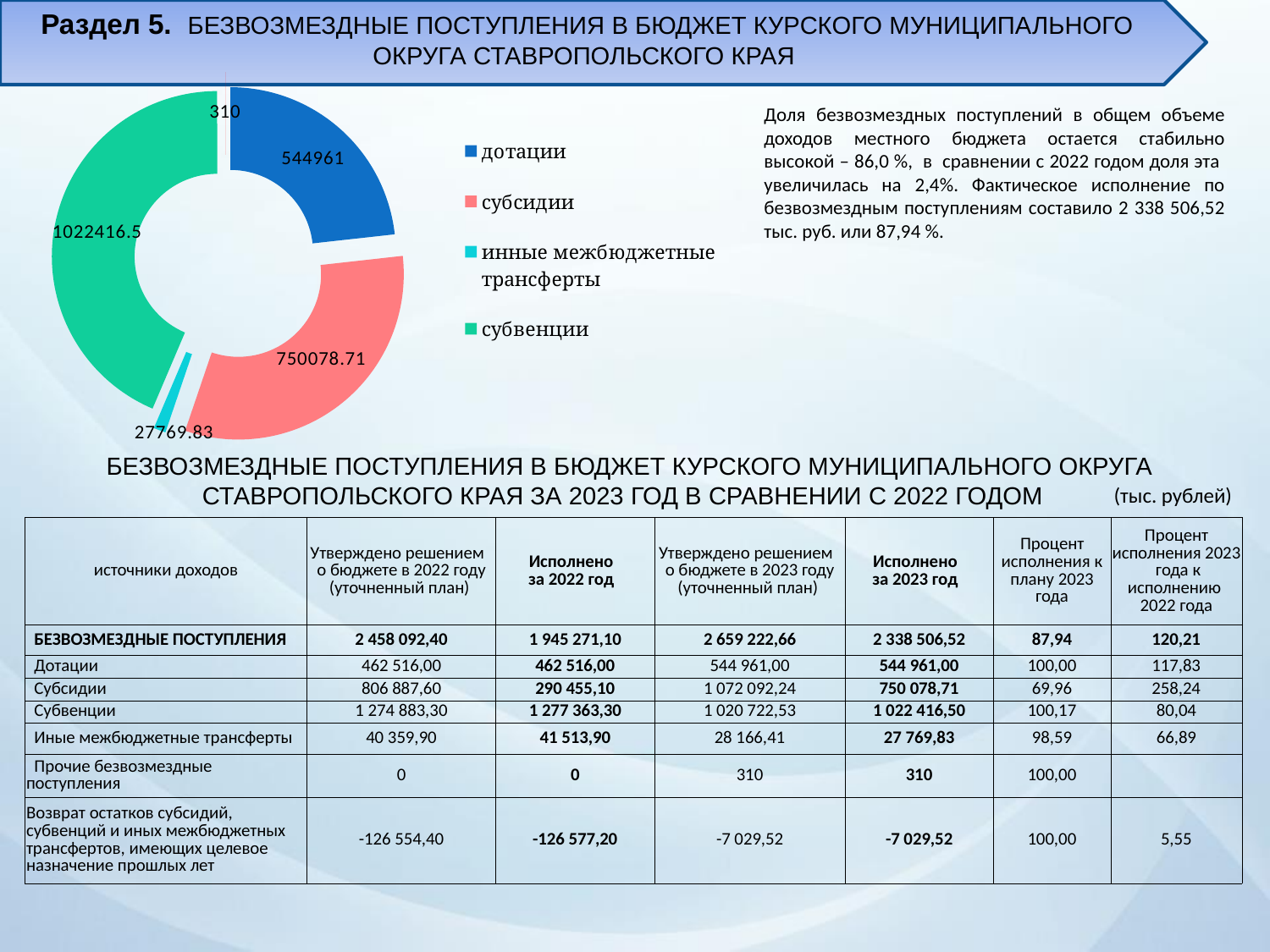
What is the difference between the values for субвенции and субсидии in the doughnut chart? 272337.79 What is the difference between the values for субсидии and дотации in the doughnut chart? 205117.71 What type of chart is shown on the slide? doughnut chart What value is shown for субсидии in the doughnut chart? 750078.71 How many entries does the legend of the doughnut chart list? 4 What value is shown for иные межбюджетные трансферты in the doughnut chart? 27769.83 Which is larger in the doughnut chart: субсидии or дотации? субсидии What value is shown for дотации in the doughnut chart? 544961 Which category has the largest value in the doughnut chart? субвенции What value is shown for субвенции in the doughnut chart? 1022416.5 Which of the four legend categories has the smallest value in the doughnut chart? иные межбюджетные трансферты What is the smallest data label shown on the doughnut chart? 310